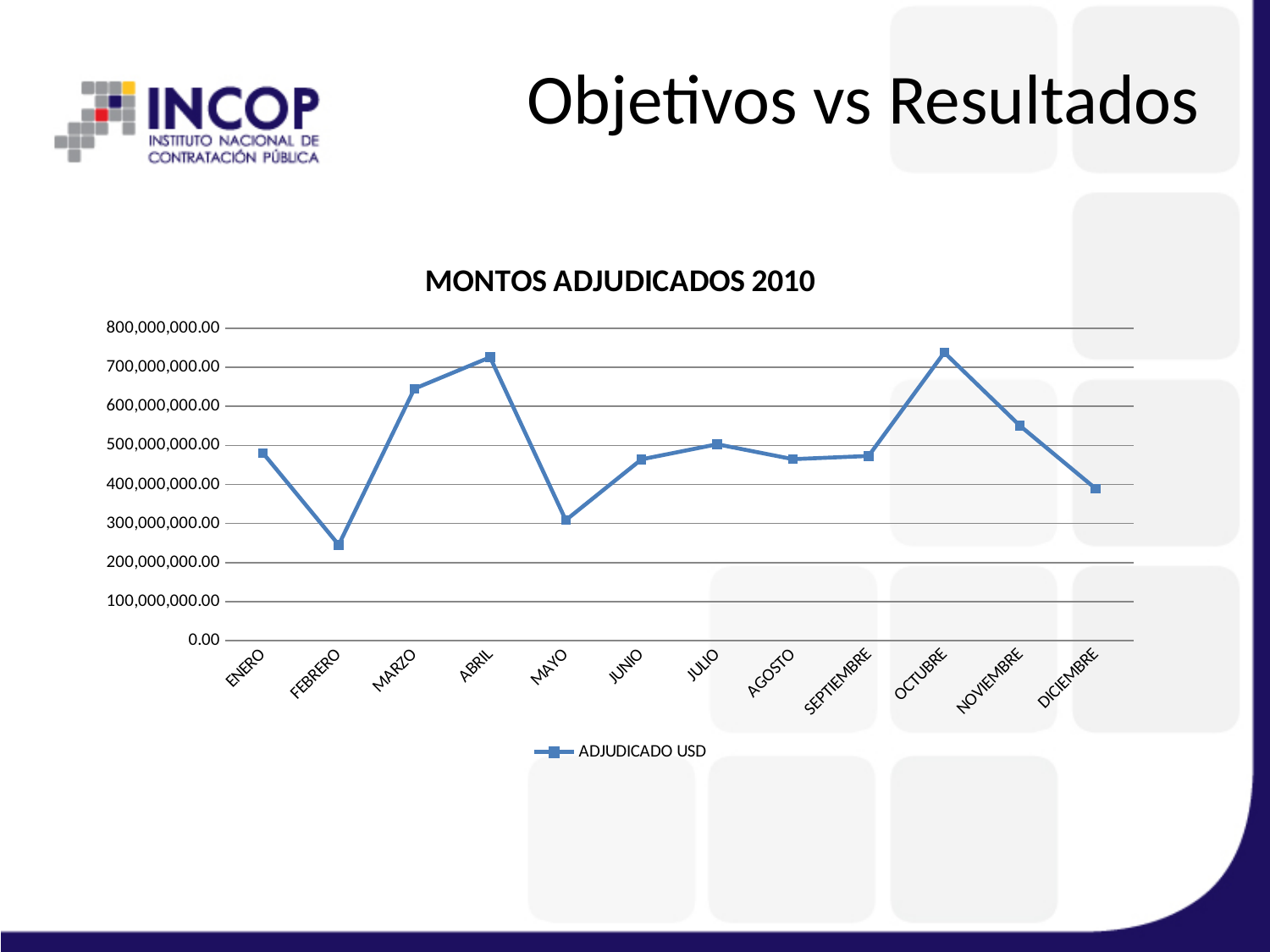
What kind of chart is shown on the slide? line chart Is the value for FEBRERO greater or less than 300,000,000.00? less Which month has the lowest value? FEBRERO Is the value for NOVIEMBRE greater or less than 500,000,000.00? greater What is the title of the chart? MONTOS ADJUDICADOS 2010 Which is larger, the value for MARZO or the value for MAYO? MARZO How many series does the legend list? 1 What is the name of the series shown in the legend? ADJUDICADO USD Do the values rise or fall from OCTUBRE to DICIEMBRE? fall How many months are plotted along the x axis? 12 Is the value for MARZO greater or less than 600,000,000.00? greater